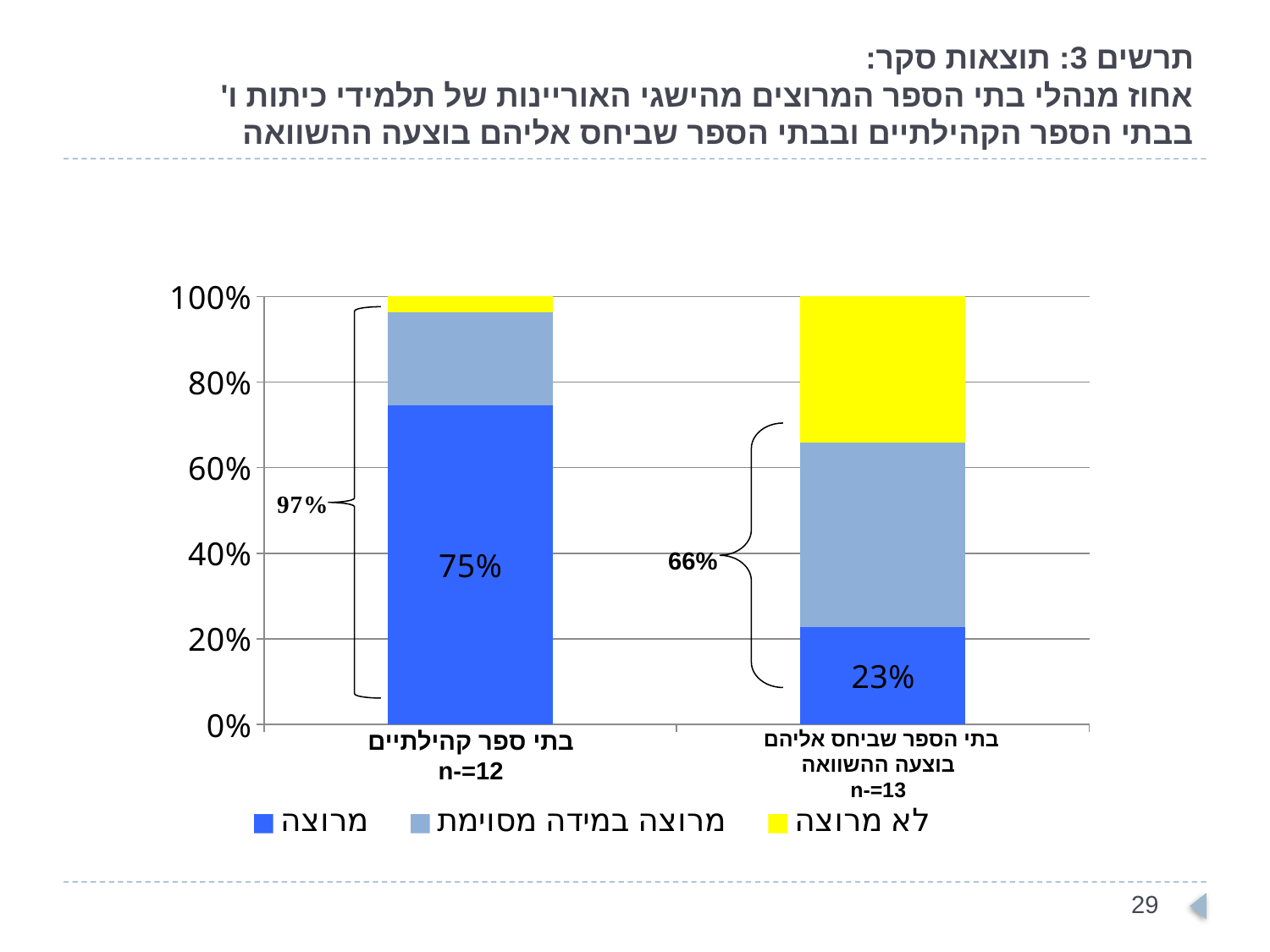
What kind of chart is shown on the slide? Stacked bar chart What is the combined share of satisfied and somewhat satisfied principals in the comparison schools, as shown by the bracket label? 66% How many series does the legend list? 3 What percentage of principals in community schools (בתי ספר קהילתיים) are satisfied (מרוצה)? 75% What is the combined share of satisfied and somewhat satisfied principals in community schools, as shown by the bracket label? 97% Is the share of not satisfied (לא מרוצה) principals in the comparison schools greater or less than 20%? greater What percentage of principals in the comparison schools (בתי הספר שביחס אליהם בוצעה ההשוואה) are satisfied (מרוצה)? 23% Which group has the larger share of satisfied (מרוצה) principals: community schools or comparison schools? Community schools (בתי ספר קהילתיים) Which colour represents the 'לא מרוצה' (not satisfied) series in the legend? Yellow How many school groups (bars) are shown in the chart? 2 What is the difference in percentage points between the satisfied (מרוצה) share in community schools and in comparison schools? 52 percentage points Is the share of not satisfied (לא מרוצה) principals in community schools greater or less than 20%? less